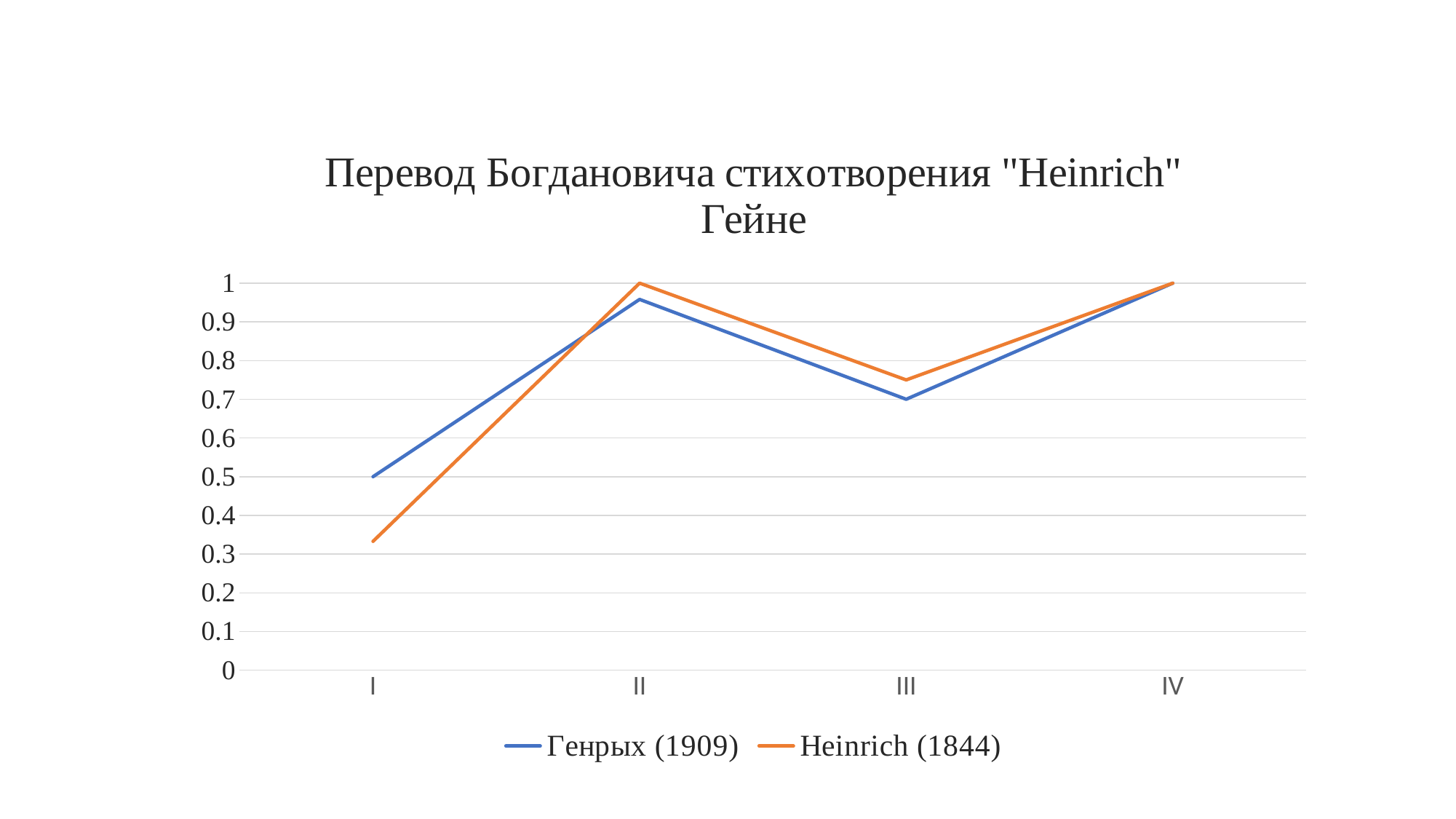
How many categories are shown on the x axis? 4 At category I, which series has the larger value, Генрых (1909) or Heinrich (1844)? Генрых (1909) What is the value for Генрых (1909) at category III? 0.7 What kind of chart is shown on the slide? line chart What is the difference between the Генрых (1909) values at category IV and category I? 0.5 At which category is the Heinrich (1844) series lowest? I How many series does the legend list? 2 What is the value for Генрых (1909) at category I? 0.5 What is the value for Генрых (1909) at category IV? 1 Does the Генрых (1909) series rise or fall from category II to category III? fall Is the value for Heinrich (1844) at category I greater or less than 0.4? less What is the value for Heinrich (1844) at category II? 1